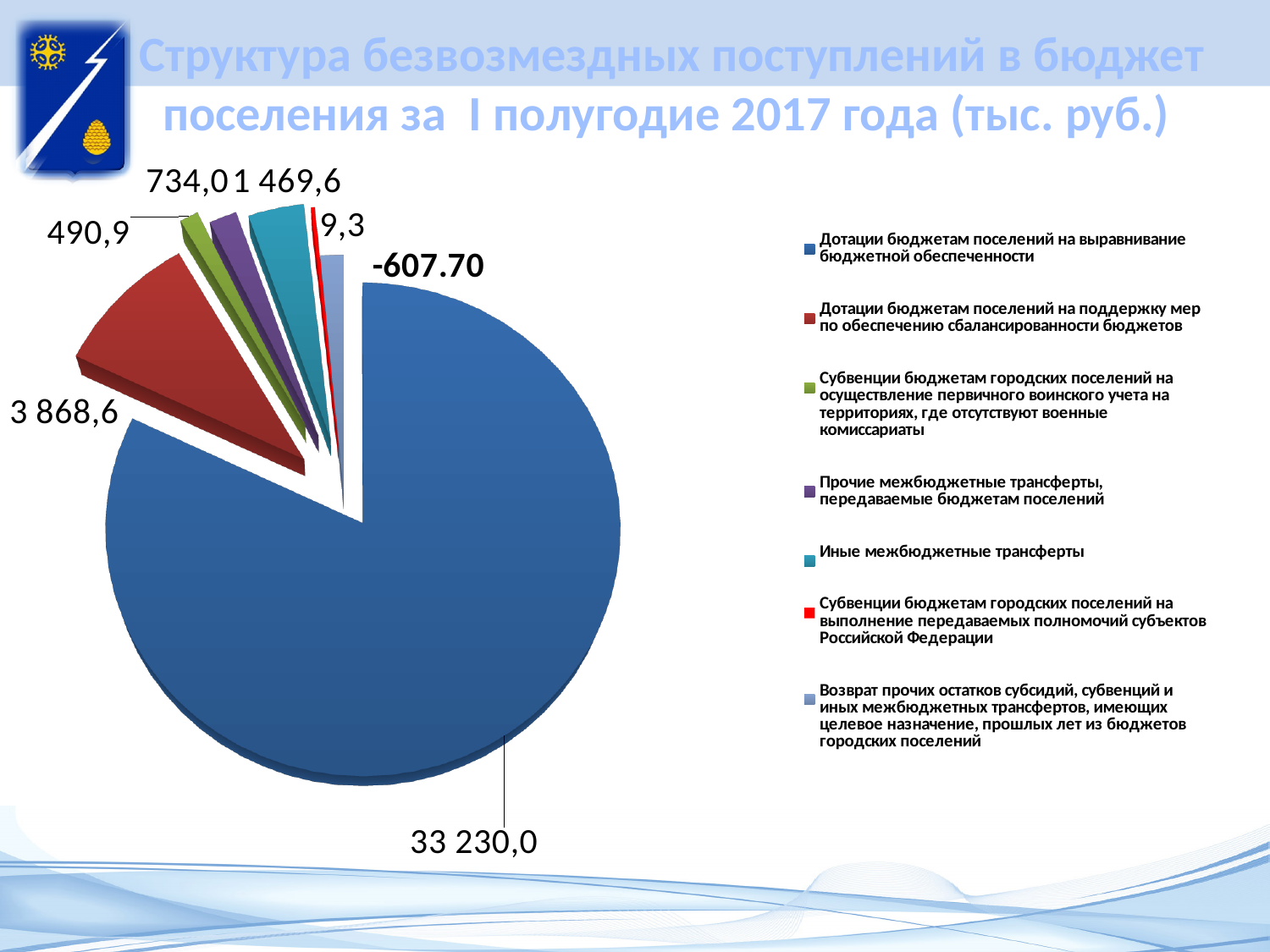
What is the value for "Дотации бюджетам поселений на поддержку мер по обеспечению сбалансированности бюджетов"? 3 868,6 Which category has the largest value in the pie chart? Дотации бюджетам поселений на выравнивание бюджетной обеспеченности What is the value for "Прочие межбюджетные трансферты, передаваемые бюджетам поселений"? 734,0 What type of chart is shown on the slide? Pie chart What is the value for "Иные межбюджетные трансферты"? 1 469,6 What is the value for "Дотации бюджетам поселений на выравнивание бюджетной обеспеченности"? 33 230,0 Which category has the smallest positive value in the pie chart? Субвенции бюджетам городских поселений на выполнение передаваемых полномочий субъектов Российской Федерации What is the title of the slide? Структура безвозмездных поступлений в бюджет поселения за I полугодие 2017 года (тыс. руб.) What is the value for "Возврат прочих остатков субсидий, субвенций и иных межбюджетных трансфертов, имеющих целевое назначение, прошлых лет из бюджетов городских поселений"? -607.70 How many categories does the legend of the pie chart list? 7 What is the difference between the value for "Дотации бюджетам поселений на выравнивание бюджетной обеспеченности" and the value for "Дотации бюджетам поселений на поддержку мер по обеспечению сбалансированности бюджетов"? 29 361,4 Which is larger: the value for "Иные межбюджетные трансферты" or the value for "Прочие межбюджетные трансферты, передаваемые бюджетам поселений"? Иные межбюджетные трансферты